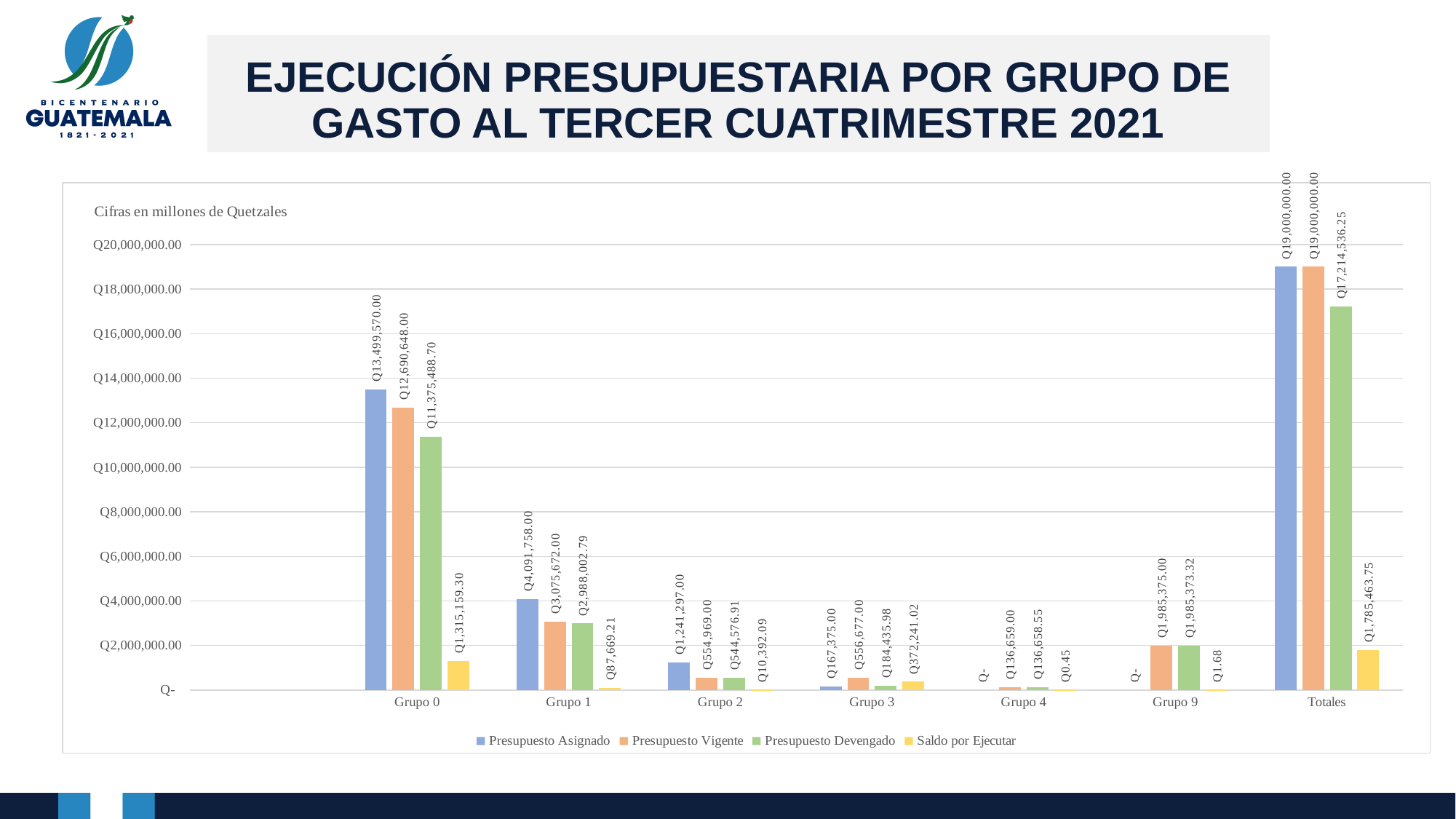
For Grupo 3, which is larger: Presupuesto Asignado or Presupuesto Vigente? Presupuesto Vigente Among Grupo 0 through Grupo 9 (excluding Totales), which group has the highest Presupuesto Devengado? Grupo 0 What is the Presupuesto Devengado value for Totales? Q17,214,536.25 What is the Presupuesto Asignado value for Grupo 0? Q13,499,570.00 What is the Saldo por Ejecutar value for Grupo 1? Q87,669.21 How many categories are shown on the x axis? 7 Among Grupo 0 through Grupo 9 (excluding Totales), which group has the lowest Presupuesto Vigente? Grupo 4 What kind of chart is shown on the slide? bar chart What is the Presupuesto Vigente value for Grupo 9? Q1,985,375.00 What is the difference between Presupuesto Asignado and Presupuesto Vigente for Grupo 0? Q808,922.00 How many series does the legend list? 4 Is the Presupuesto Asignado value for Grupo 2 greater or less than Q2,000,000.00? less